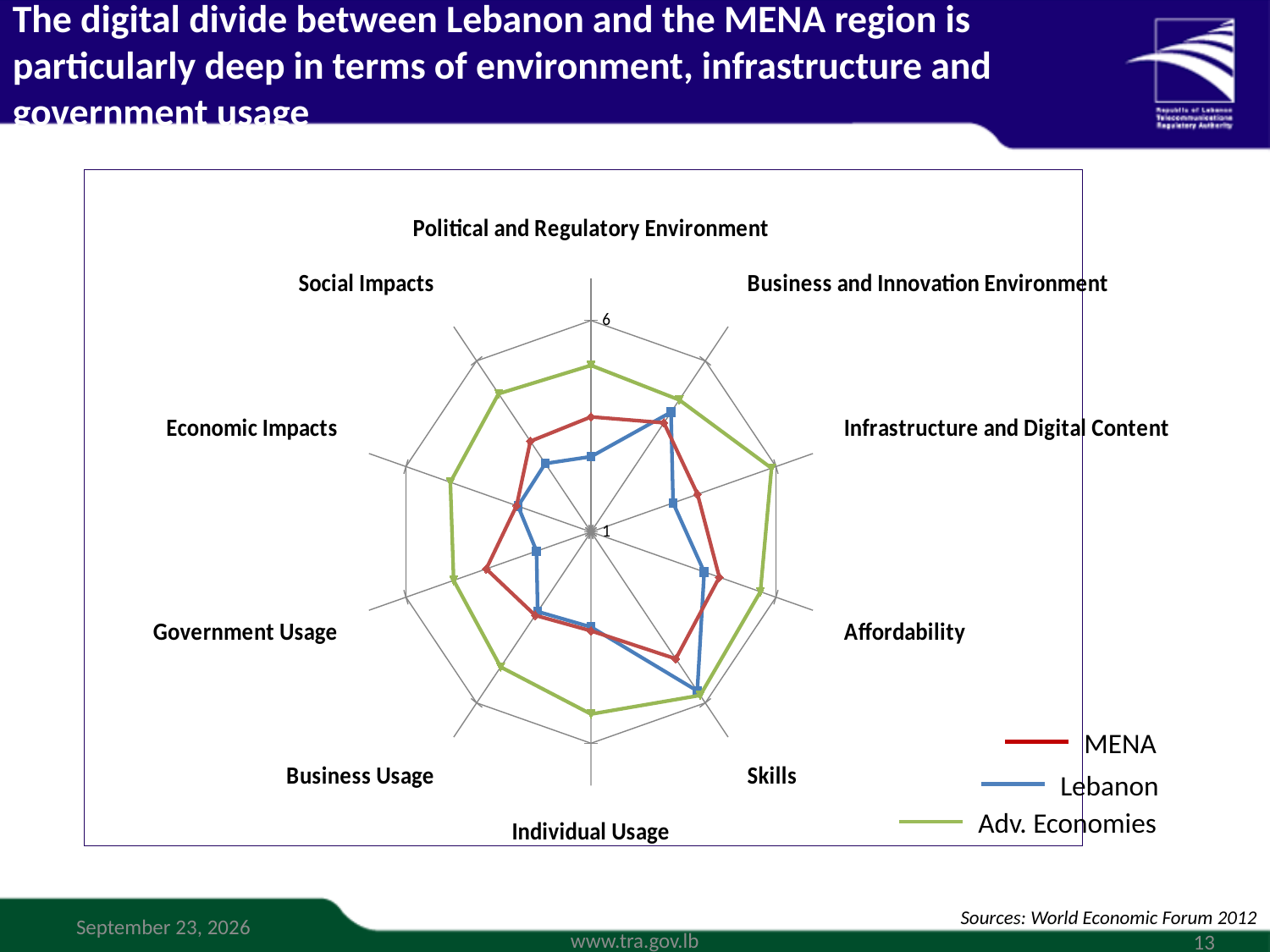
Which series has the lowest value for Political and Regulatory Environment? Lebanon Which series has the lowest value for Government Usage? Lebanon Which series are listed in the legend? MENA, Lebanon, Adv. Economies On which category does Lebanon reach its highest value? Skills For Social Impacts, which is larger: Lebanon or Adv. Economies? Adv. Economies Which series has the highest value for Infrastructure and Digital Content? Adv. Economies How many series does the legend list? 3 Is the Lebanon value for Skills greater or less than 6? less Which series is shown with a green line? Adv. Economies What kind of chart is shown on the slide? Radar chart How many categories (axes) does the radar chart have? 10 For Infrastructure and Digital Content, which is larger: MENA or Lebanon? MENA